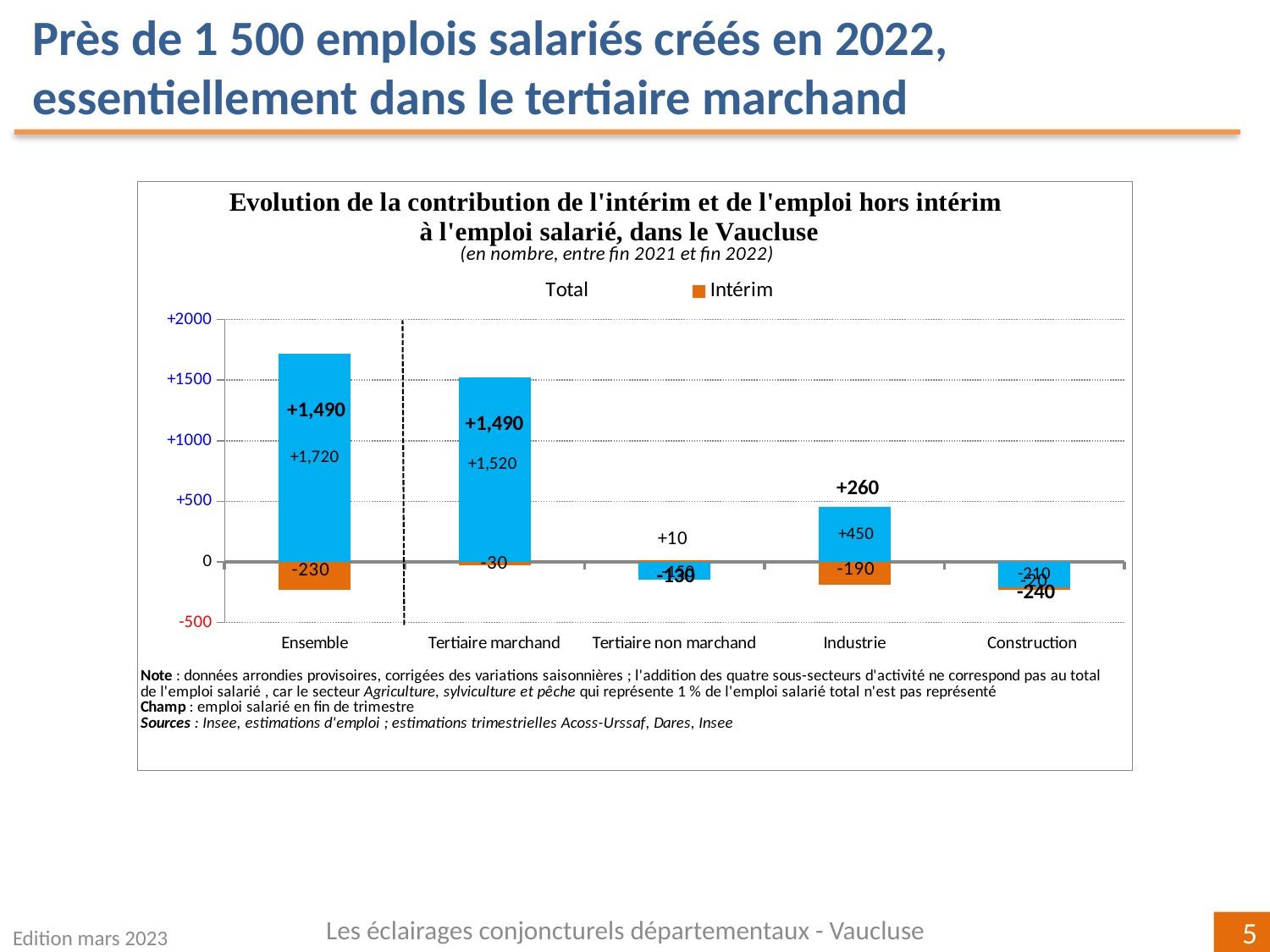
What is the Intérim value for Tertiaire non marchand? +10 What value is printed on the blue bar for Tertiaire marchand? +1,520 What is the bold total value shown for Construction? -240 How many categories are shown on the x axis? 5 What is the bold total value shown for Industrie? +260 What kind of chart is shown on the slide? bar chart What is the difference between the blue bar values for Ensemble (+1,720) and Tertiaire marchand (+1,520)? 200 What is the Intérim value for Industrie? -190 Which has a larger blue bar value, Industrie or Tertiaire marchand? Tertiaire marchand What is the Intérim value for Ensemble? -230 Is the blue bar value for Industrie greater or less than +500? less Which category has the highest blue bar? Ensemble